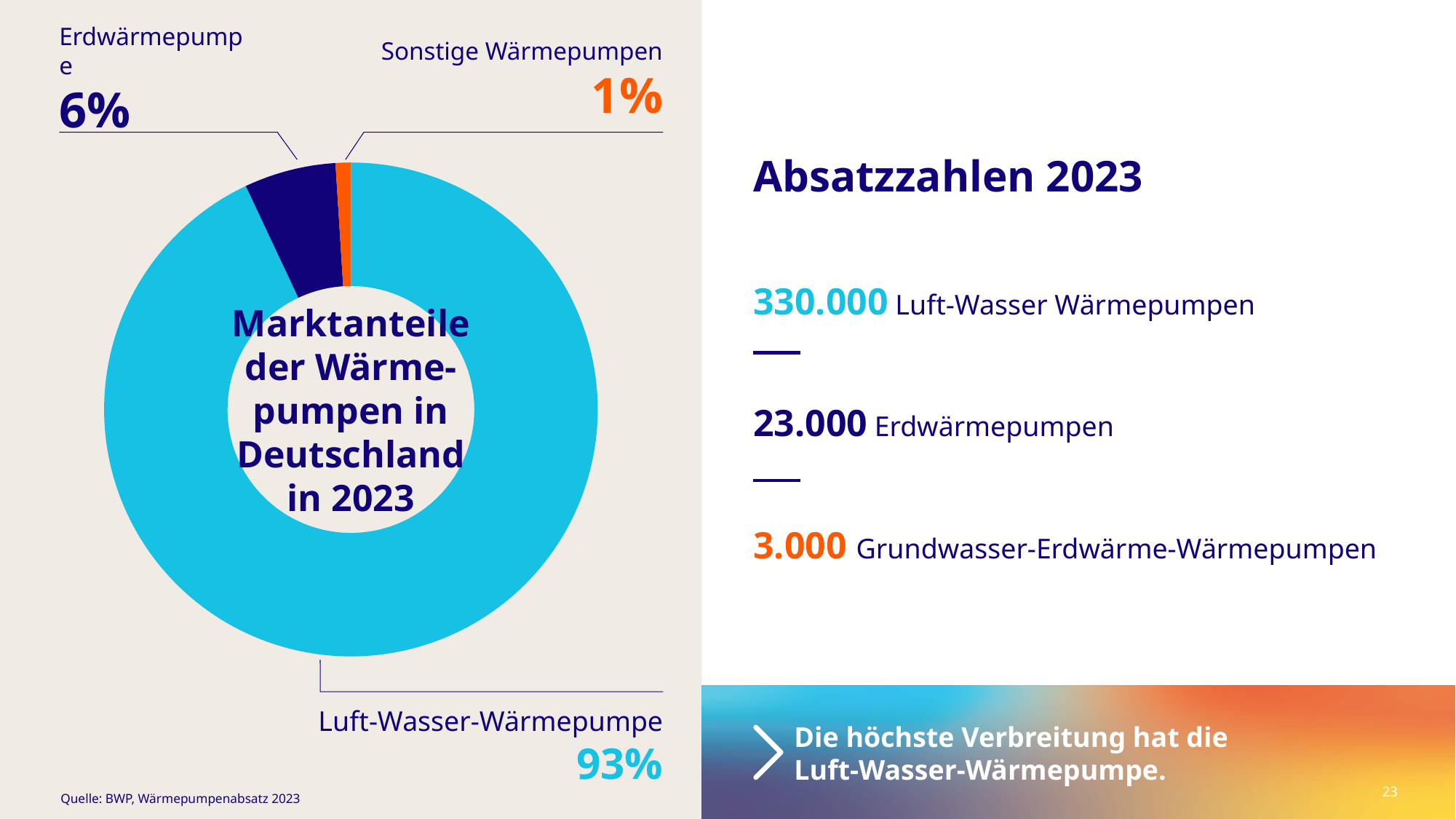
What share of the pie chart does Luft-Wasser-Wärmepumpe hold? 93% What share of the pie chart does Sonstige Wärmepumpen hold? 1% What colour is the Luft-Wasser-Wärmepumpe slice in the pie chart? Light blue Which category has the largest share in the pie chart? Luft-Wasser-Wärmepumpe What kind of chart is shown on the slide? Pie chart (donut) What is the title shown in the centre of the pie chart? Marktanteile der Wärmepumpen in Deutschland in 2023 What is the difference in percentage points between the Luft-Wasser-Wärmepumpe share and the Erdwärmepumpe share? 87 percentage points How many categories are shown in the pie chart? 3 Which category has the smallest share in the pie chart? Sonstige Wärmepumpen What share of the pie chart does Erdwärmepumpe hold? 6% Which has the larger share, Erdwärmepumpe or Sonstige Wärmepumpen? Erdwärmepumpe What is the combined share of Erdwärmepumpe and Sonstige Wärmepumpen in the pie chart? 7%